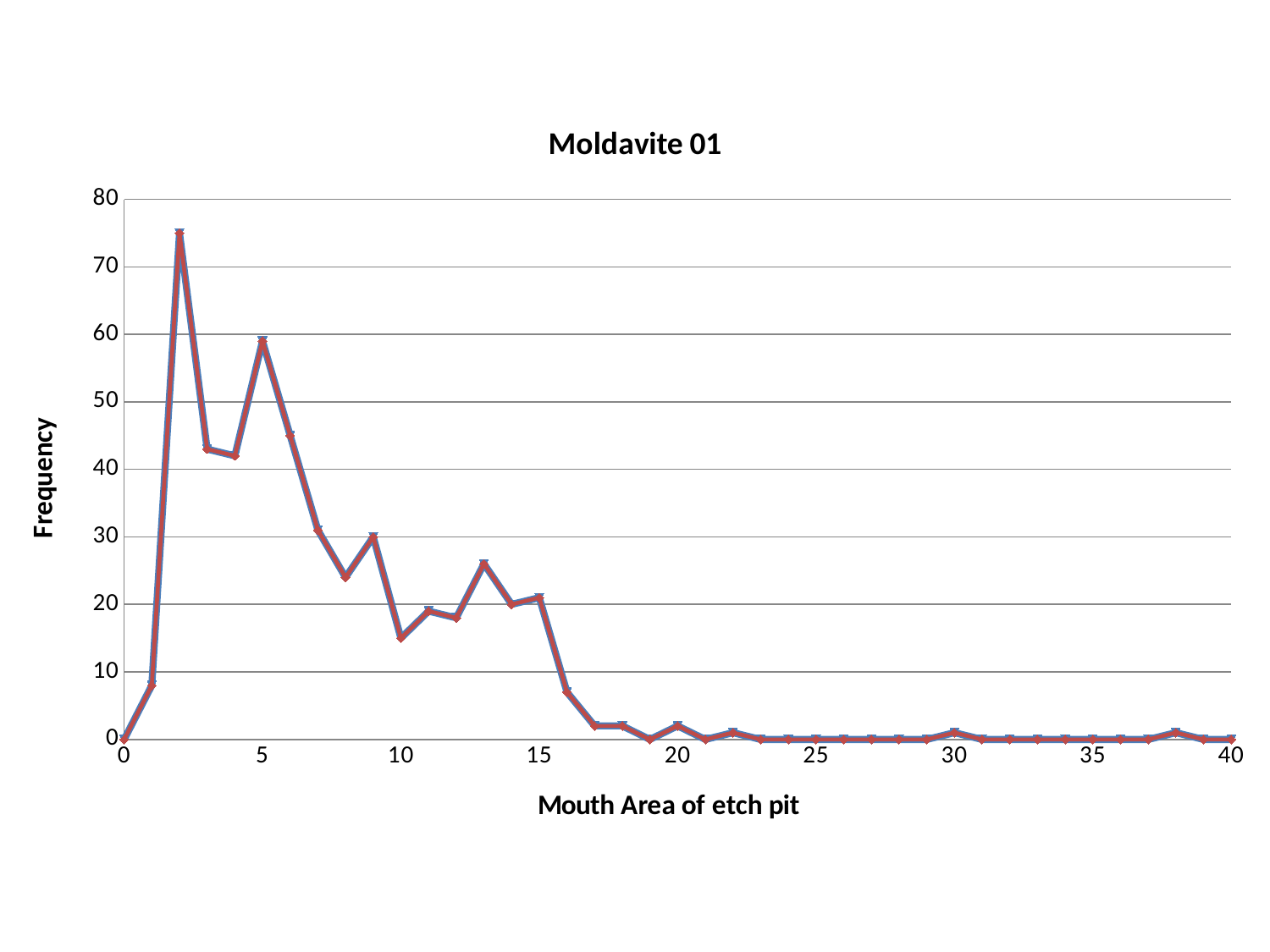
What is the label of the x axis? Mouth Area of etch pit At which mouth area value does the frequency reach its highest point? 2 Is the frequency at mouth area 13 greater or less than 20? greater What kind of chart is shown on the slide? line chart Is the frequency at mouth area 10 greater or less than 20? less Is the frequency at mouth area 2 greater or less than 70? greater Which has the higher frequency, mouth area 2 or mouth area 5? 2 After the peak at mouth area 2, does the frequency generally rise or fall as mouth area increases toward 40? fall What is the title of the chart? Moldavite 01